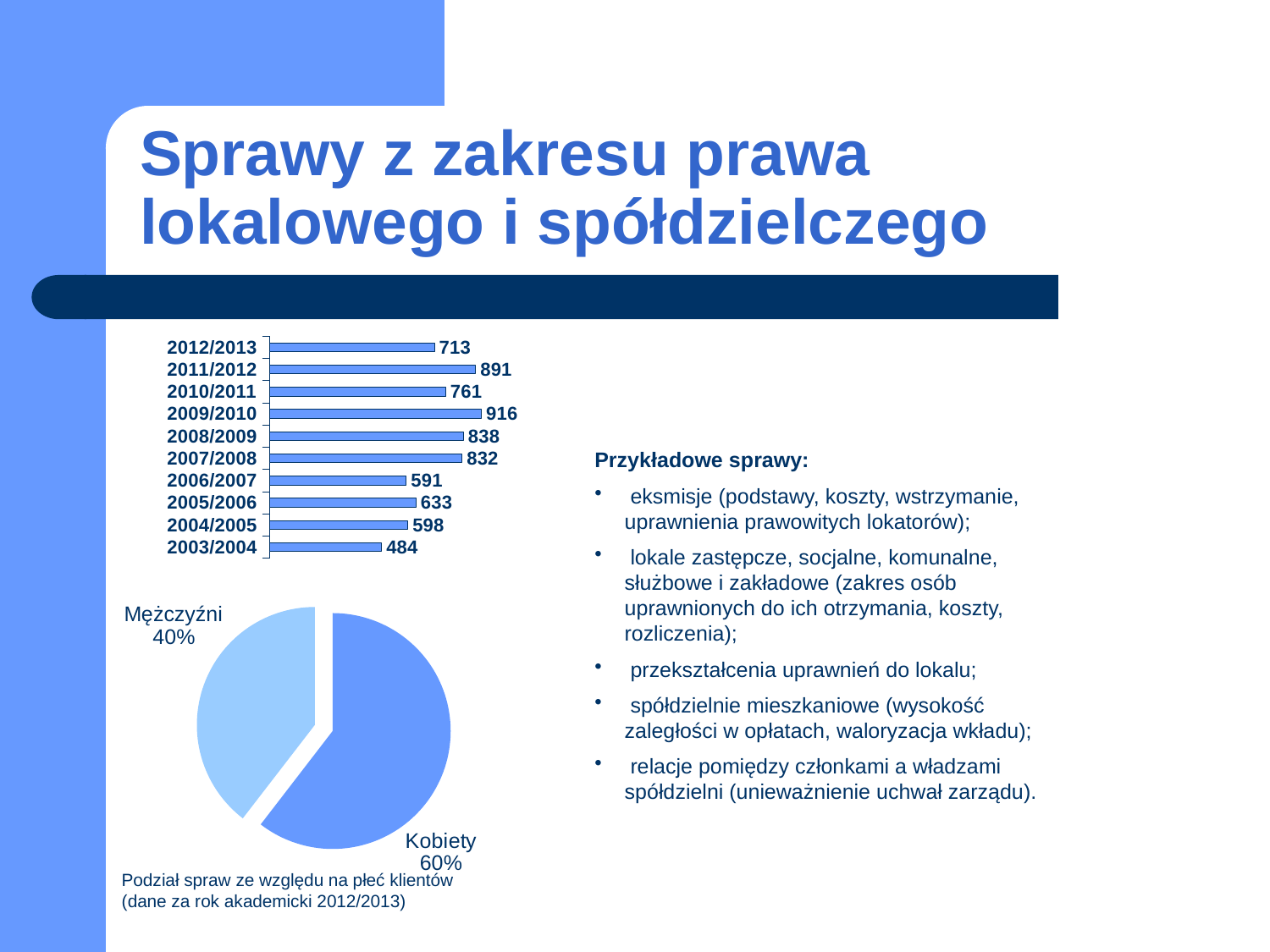
In the bar chart at the top left, what is the value for 2009/2010? 916 In the bar chart at the top left, what is the value for 2003/2004? 484 In the bar chart at the top left, which academic year has the lowest value? 2003/2004 In the pie chart at the bottom left, what share is labelled Mężczyźni? 40% In the bar chart at the top left, which is larger, the value for 2005/2006 or the value for 2004/2005? 2005/2006 In the bar chart at the top left, what is the value for 2012/2013? 713 In the bar chart at the top left, which academic year has the highest value? 2009/2010 In the pie chart at the bottom left, what share is labelled Kobiety? 60% In the bar chart at the top left, how many academic years are shown? 10 In the pie chart at the bottom left, how many slices are there? 2 What kind of chart is the chart at the top left of the slide? Bar chart In the bar chart at the top left, what is the difference between the values for 2011/2012 and 2012/2013? 178